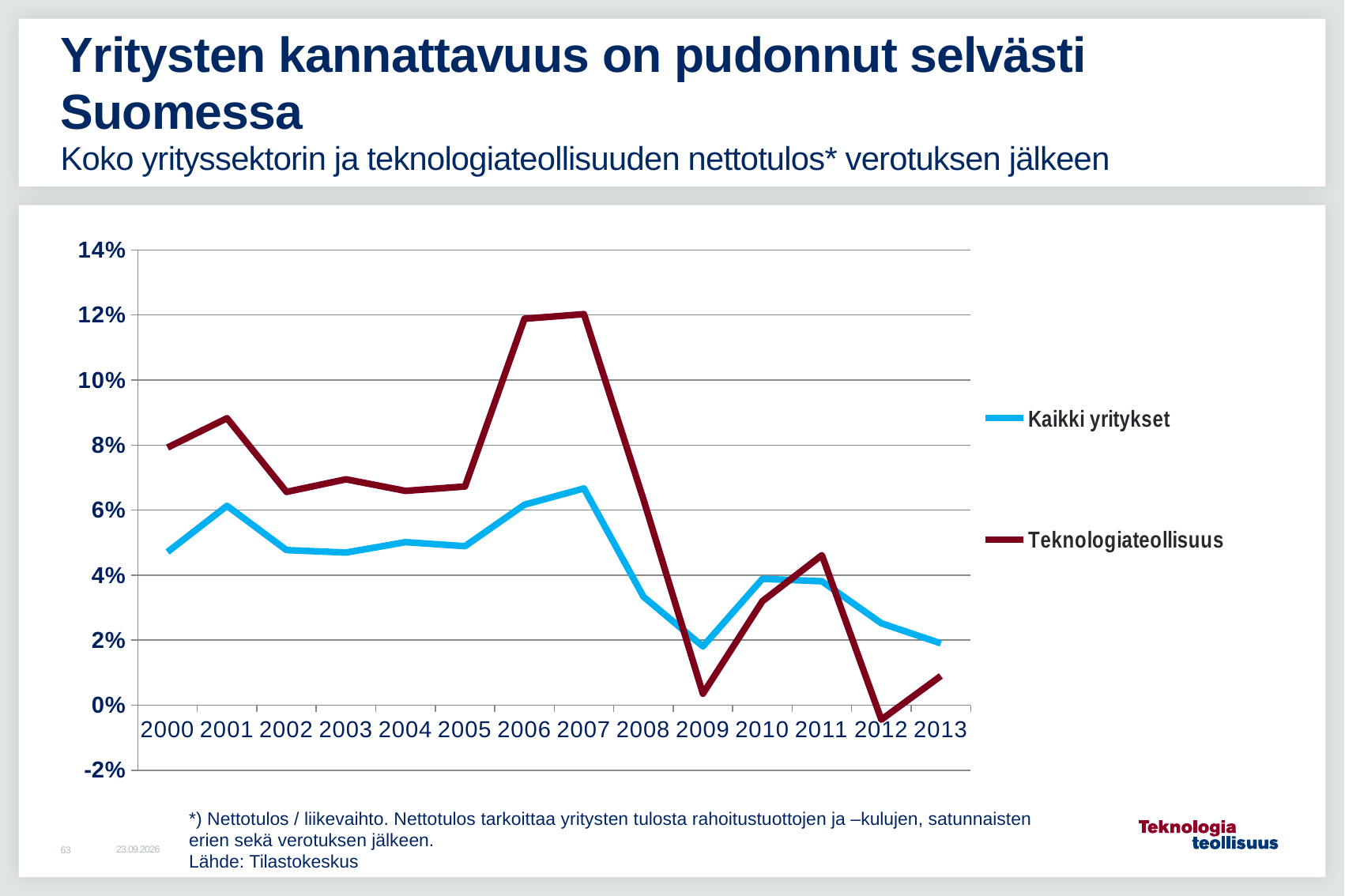
In which year does the Teknologiateollisuus line reach its lowest value? 2012 Is the value for Teknologiateollisuus in 2012 greater or less than 0%? less Is the value for Kaikki yritykset in 2000 greater or less than 6%? less Is the value for Teknologiateollisuus in 2007 greater or less than 10%? greater Does the Kaikki yritykset line rise or fall from 2007 to 2009? fall Which series has the higher value in 2011, Kaikki yritykset or Teknologiateollisuus? Teknologiateollisuus What kind of chart is shown on the slide? line chart Which series has the higher value in 2009, Kaikki yritykset or Teknologiateollisuus? Kaikki yritykset How many series does the legend list? 2 In which year does the Kaikki yritykset line reach its highest value? 2007 How many years are shown on the x axis? 14